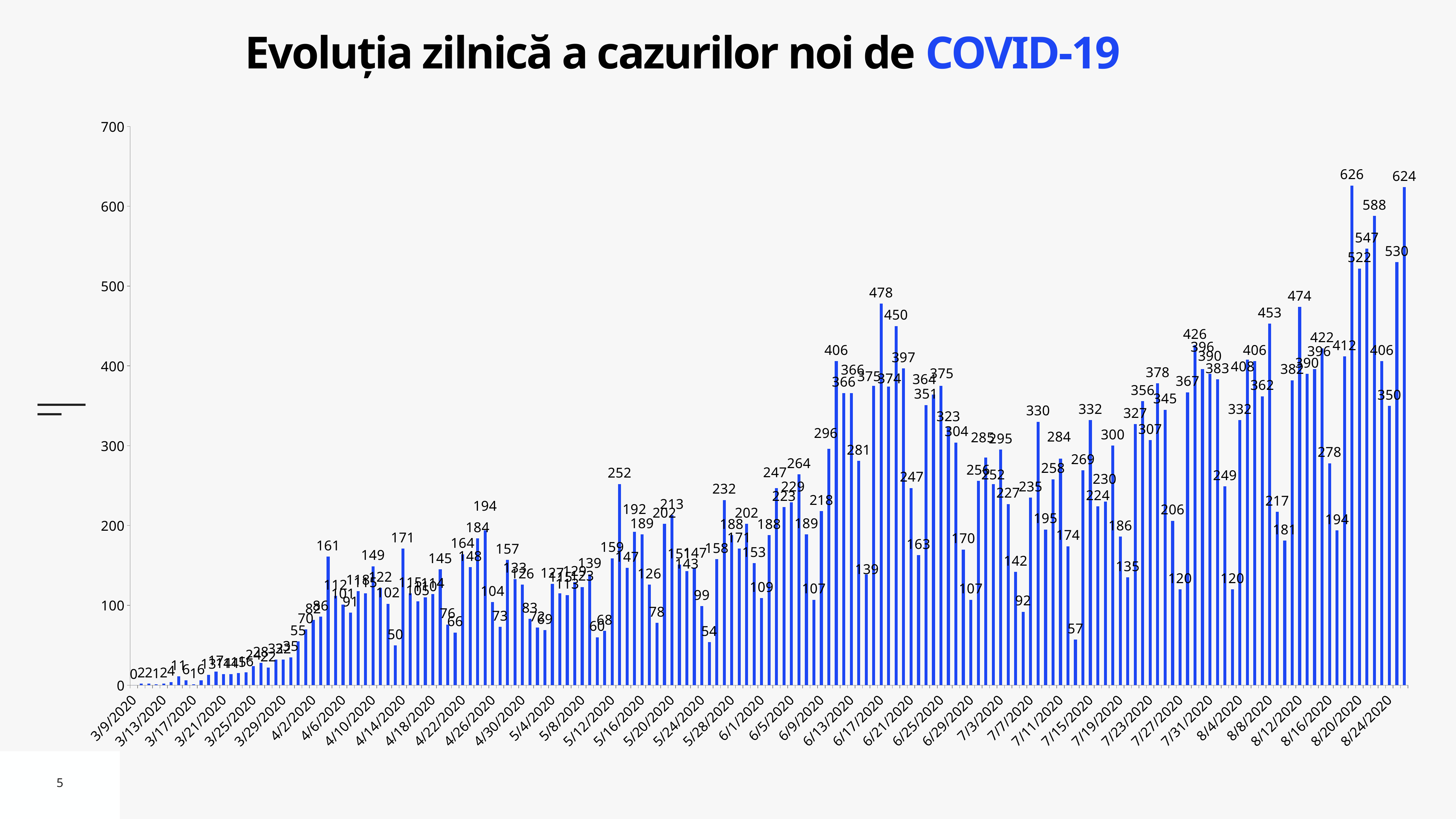
What is the title of the chart? Evoluția zilnică a cazurilor noi de COVID-19 What is the value of the last (rightmost) bar in the chart? 624 Overall, do the daily values rise or fall from March to August 2020? rise Which is larger, the highest bar (626) or the last bar (624)? 626 What is the difference between the last bar (624) and the bar just before it (530)? 94 What is the value of the first bar, for 3/9/2020? 0 What is the lowest value shown in the chart? 0 What is the maximum value shown on the vertical axis? 700 What is the difference between the highest value (626) and the last bar's value (624)? 2 Is the highest bar in the chart greater or less than 600? greater What kind of chart is shown on the slide? bar chart What is the highest daily value shown in the chart? 626